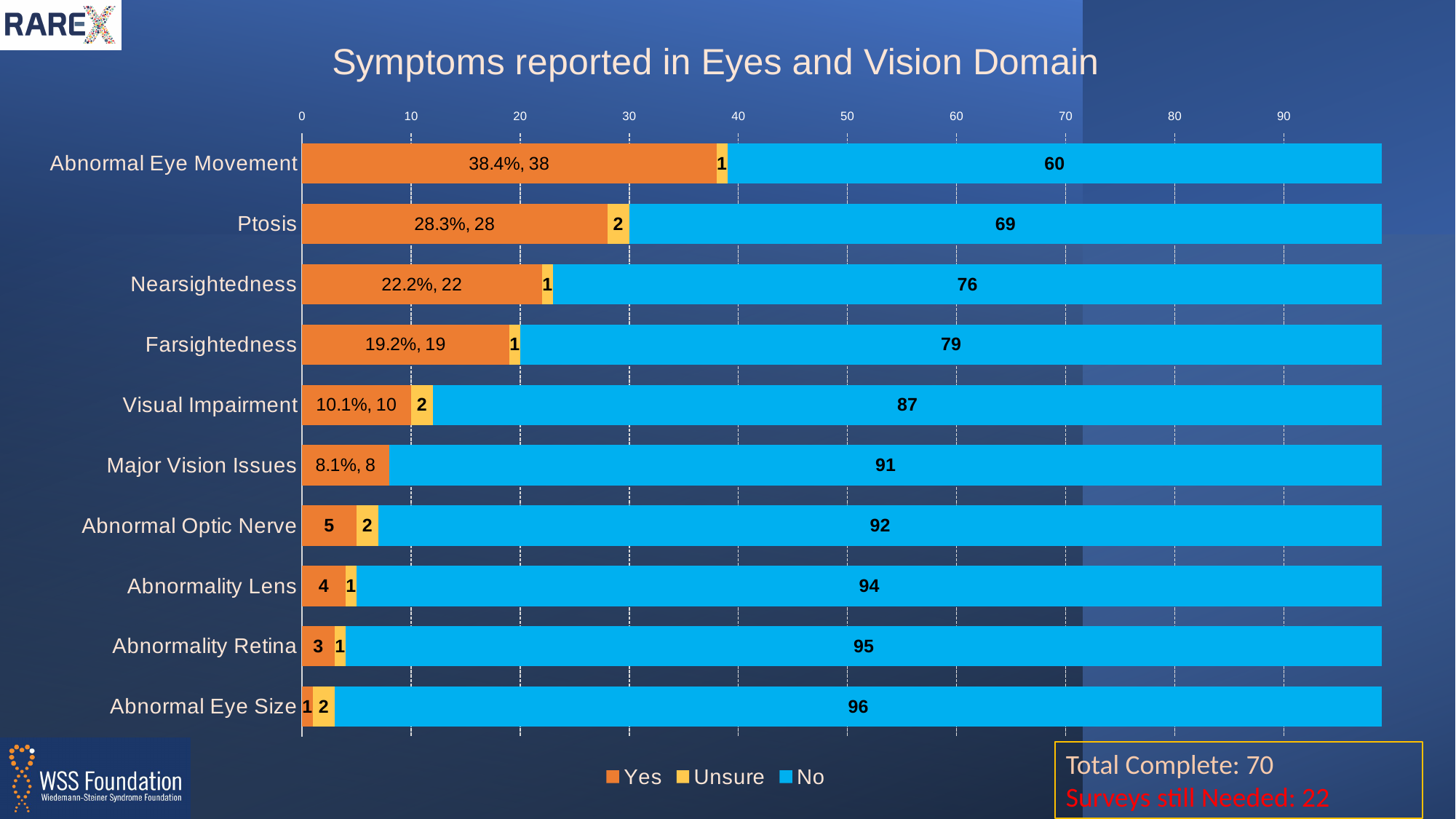
What is the difference between the 'No' values for Abnormal Eye Size and Farsightedness? 17 What kind of chart is shown on the slide? Stacked bar chart Which symptom has the highest 'Yes' value? Abnormal Eye Movement Which is larger, the 'Yes' value for Ptosis or the 'Yes' value for Visual Impairment? Ptosis How many symptom categories are plotted in the chart? 10 What is the total of the stacked bar for Abnormal Eye Movement? 99 How many series does the legend list? 3 What is the 'No' value for Ptosis? 69 What is the 'Yes' value for Nearsightedness? 22 What percentage is shown for 'Yes' on Abnormal Eye Movement? 38.4% What is the 'Unsure' value for Abnormal Optic Nerve? 2 Which symptom has the lowest 'No' value? Abnormal Eye Movement